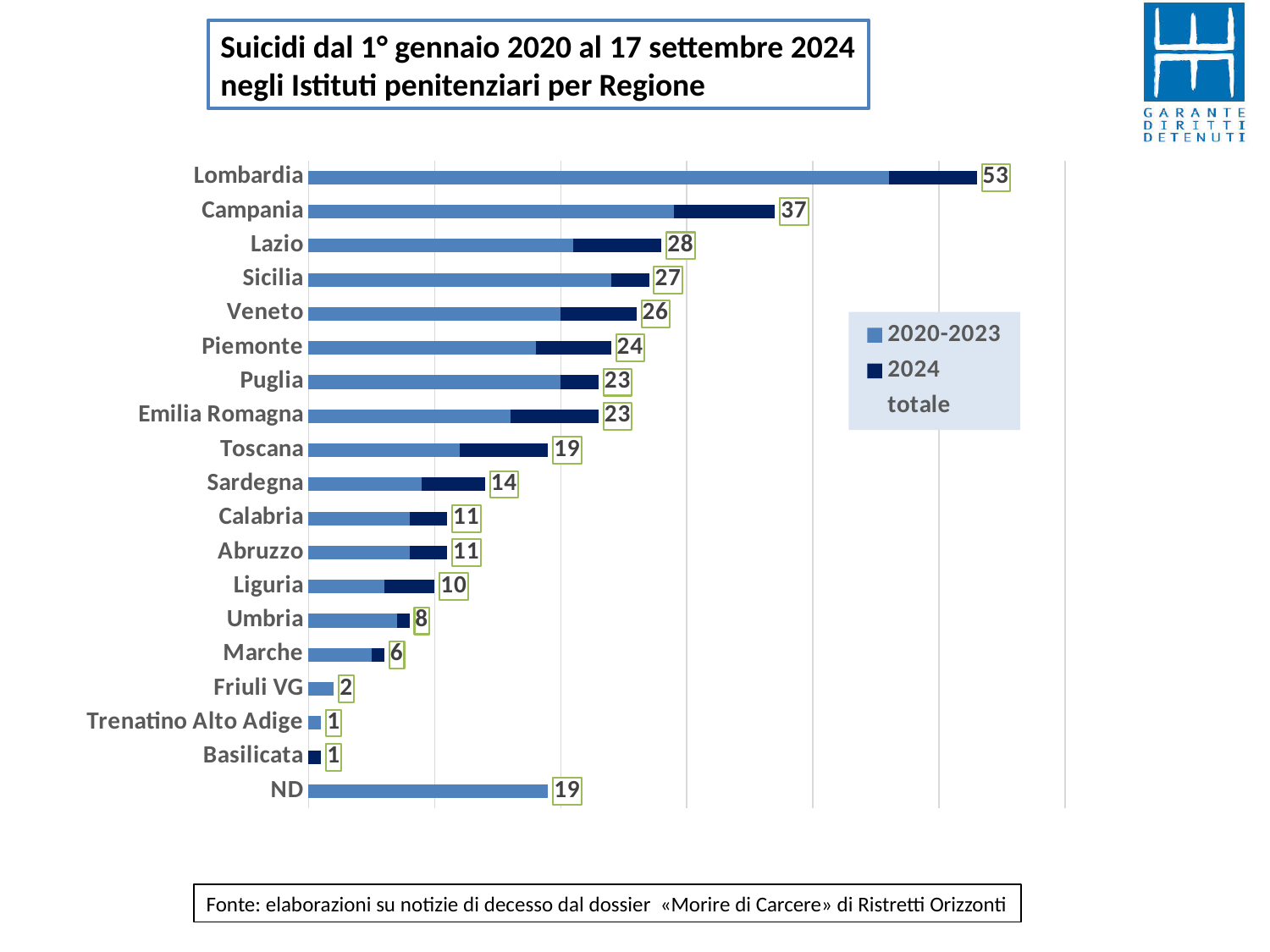
What is the total value shown for Lombardia? 53 Which region has the highest total? Lombardia Which has a larger total, Veneto or Piemonte? Veneto What is the total value shown for Campania? 37 How many entries does the legend list? 3 What is the difference between the totals for Lazio and Sicilia? 1 How many categories (bars) are shown on the chart? 19 What is the total value shown for Sardegna? 14 Which has a larger total, Liguria or Umbria? Liguria What is the difference between the totals for Lombardia and Campania? 16 What kind of chart is shown on the slide? Stacked bar chart What is the total value shown for Toscana? 19